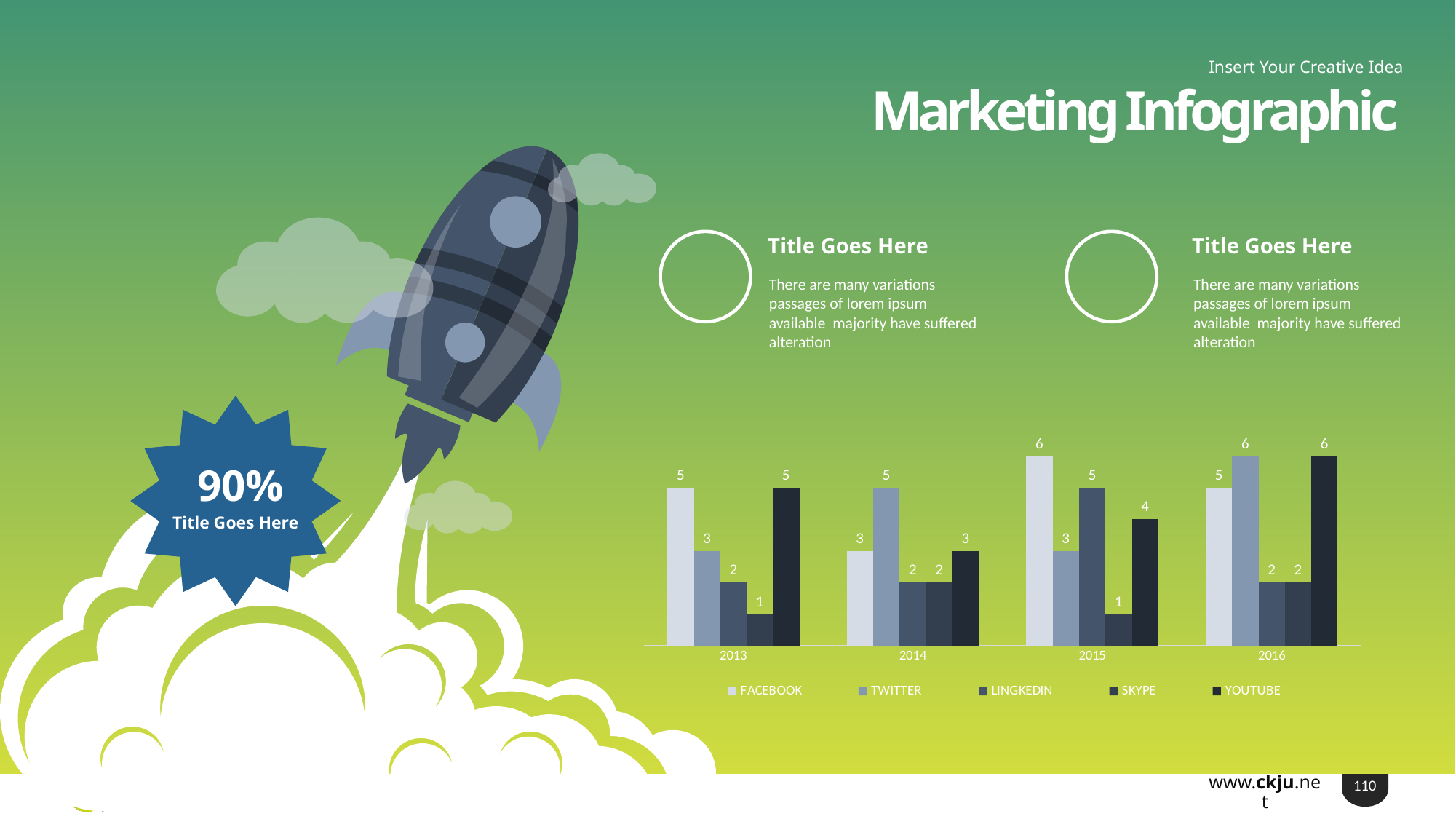
What is the value for SKYPE in 2013? 1 Which series has the highest value in 2014? TWITTER How many years are shown on the x axis of the chart? 4 What is the value for YOUTUBE in 2016? 6 Which is larger in 2016, the value for TWITTER or the value for LINGKEDIN? TWITTER What is the value for FACEBOOK in 2015? 6 What kind of chart is shown on the slide? bar chart Which series has the lowest value in 2015? SKYPE How many series does the chart legend list? 5 What is the value for TWITTER in 2014? 5 Does the value for LINGKEDIN rise or fall from 2015 to 2016? fall What is the difference between the FACEBOOK value in 2015 and the FACEBOOK value in 2014? 3